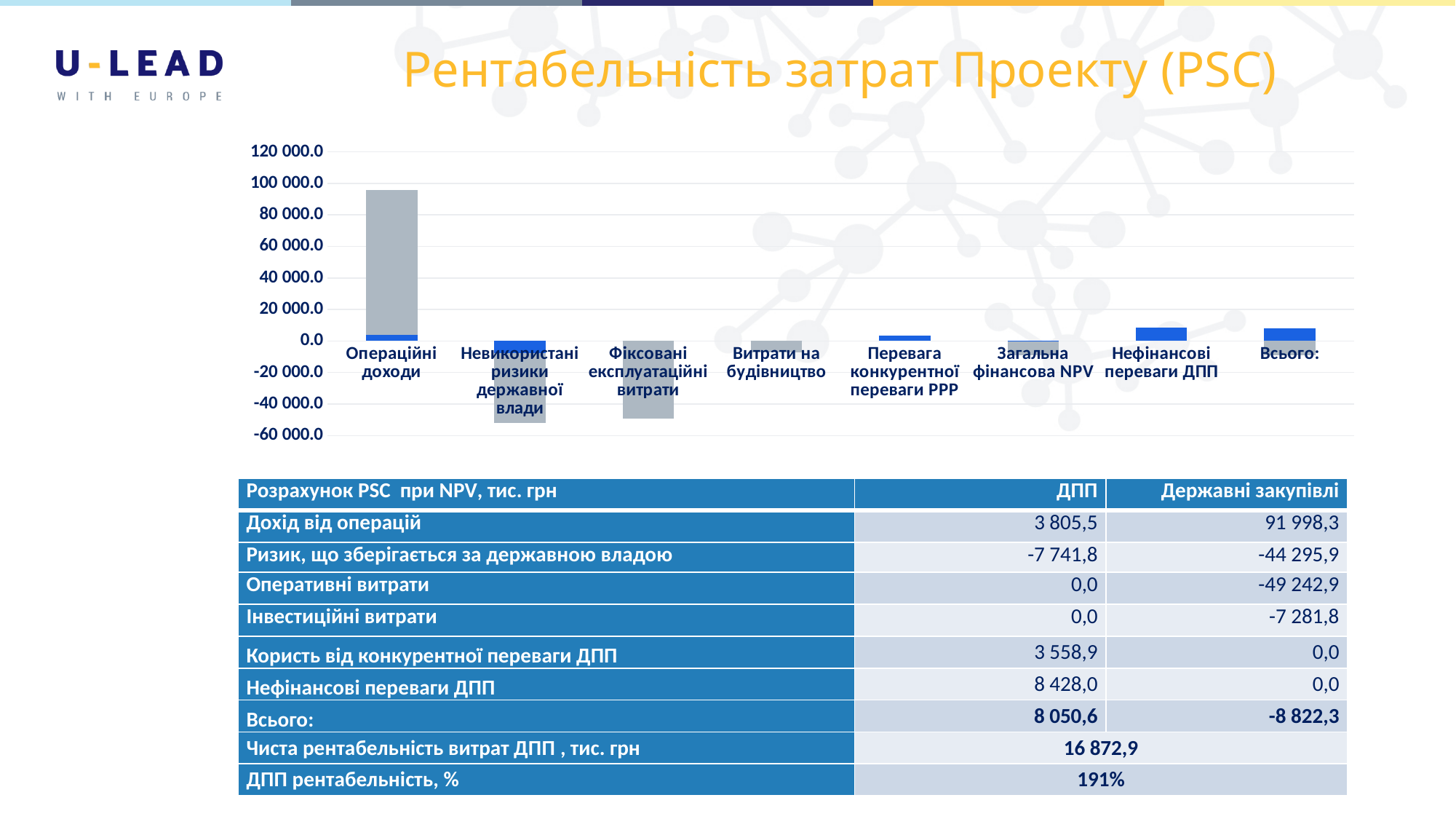
Is the blue bar for Нефінансові переваги ДПП greater or less than 0.0? greater What is the title of the slide containing the chart? Рентабельність затрат Проекту (PSC) Which grey bar is larger: Операційні доходи or Витрати на будівництво? Операційні доходи Is the grey bar for Невикористані ризики державної влади greater or less than -20 000.0? less What two colours are used for the bars in the chart? grey and blue Is the grey bar for Витрати на будівництво greater or less than -20 000.0? greater How many categories are shown on the x axis of the chart? 8 Which category has the tallest grey bar in the chart? Операційні доходи What kind of chart is shown on the slide? bar chart